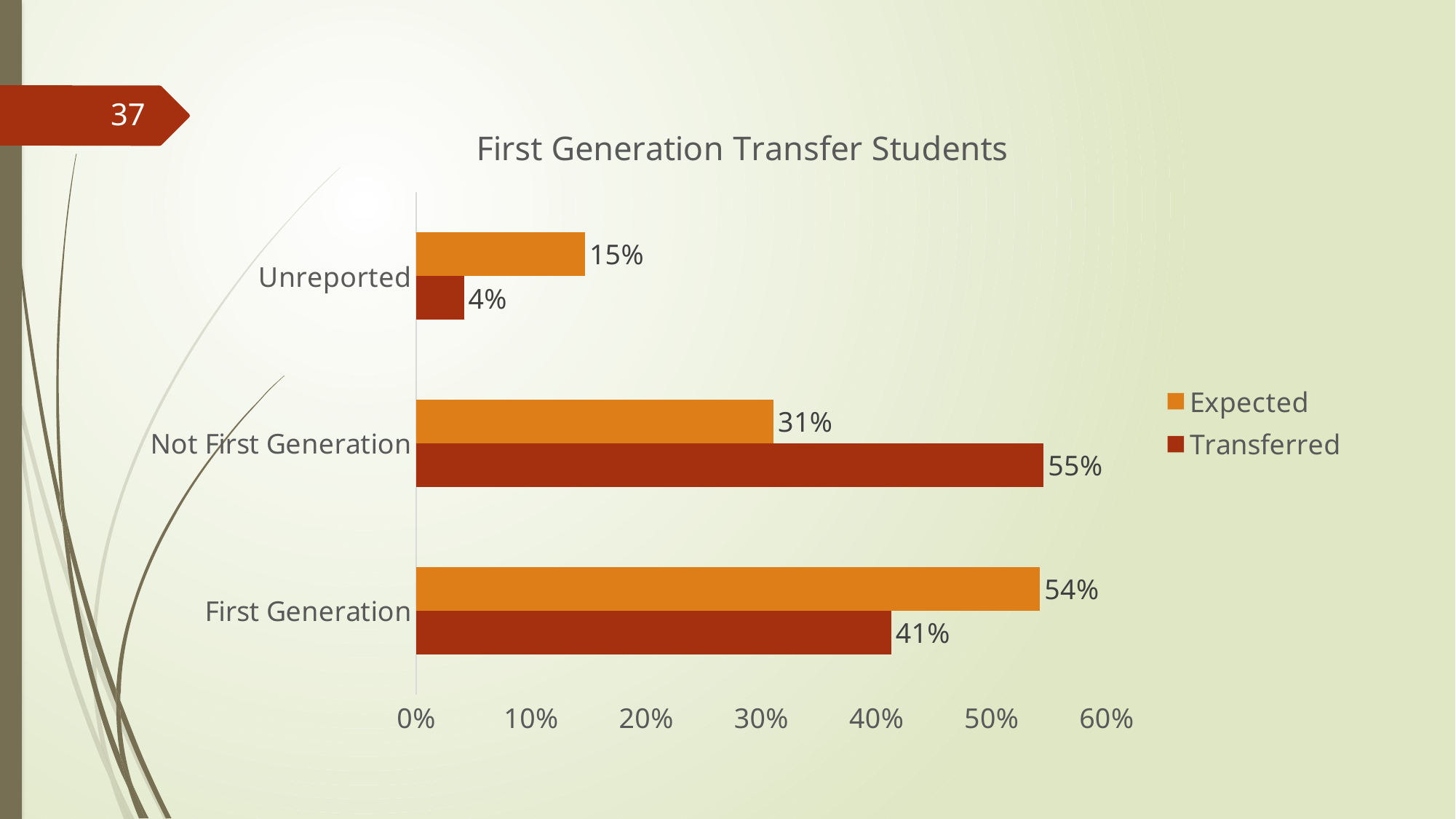
Which category has the highest Transferred value? Not First Generation Which is larger for Not First Generation, the Expected value or the Transferred value? Transferred What is the Expected value for First Generation? 54% What is the title of the chart? First Generation Transfer Students What is the difference between the Expected and Transferred values for First Generation? 13% How many series does the legend list? 2 How many categories are shown on the chart? 3 What is the Expected value for Not First Generation? 31% What is the Transferred value for Not First Generation? 55% What kind of chart is shown on the slide? Bar chart Which category has the lowest Expected value? Unreported What is the Transferred value for Unreported? 4%